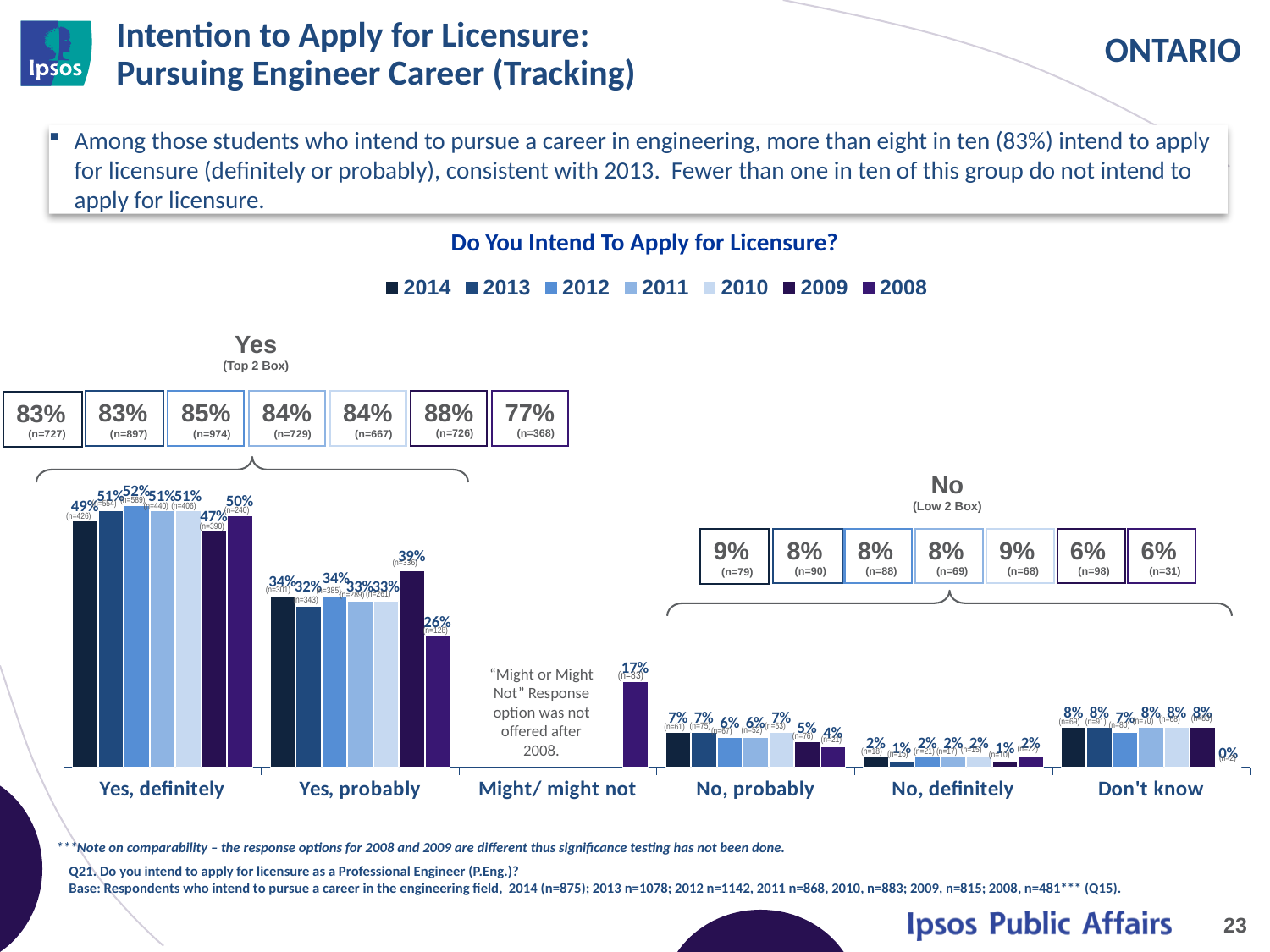
What is the value for 2008 in the "Might/ might not" category? 17% Which year has the highest value in the "Yes, definitely" category? 2012 What is the difference between the 2009 and 2008 values in the "Yes, probably" category? 13 percentage points Which year has the lowest value in the "Yes, probably" category? 2008 Which is larger in the "Don't know" category: the value for 2014 or the value for 2008? 2014 What is the title of the chart? Do You Intend To Apply for Licensure? How many years does the chart legend list? 7 What is the "Yes (Top 2 Box)" value shown for 2009? 88% What is the value for 2014 in the "Yes, definitely" category? 49% How many response categories are shown along the x axis of the chart? 6 What is the value for 2009 in the "Yes, probably" category? 39% What kind of chart is shown on the slide? Bar chart